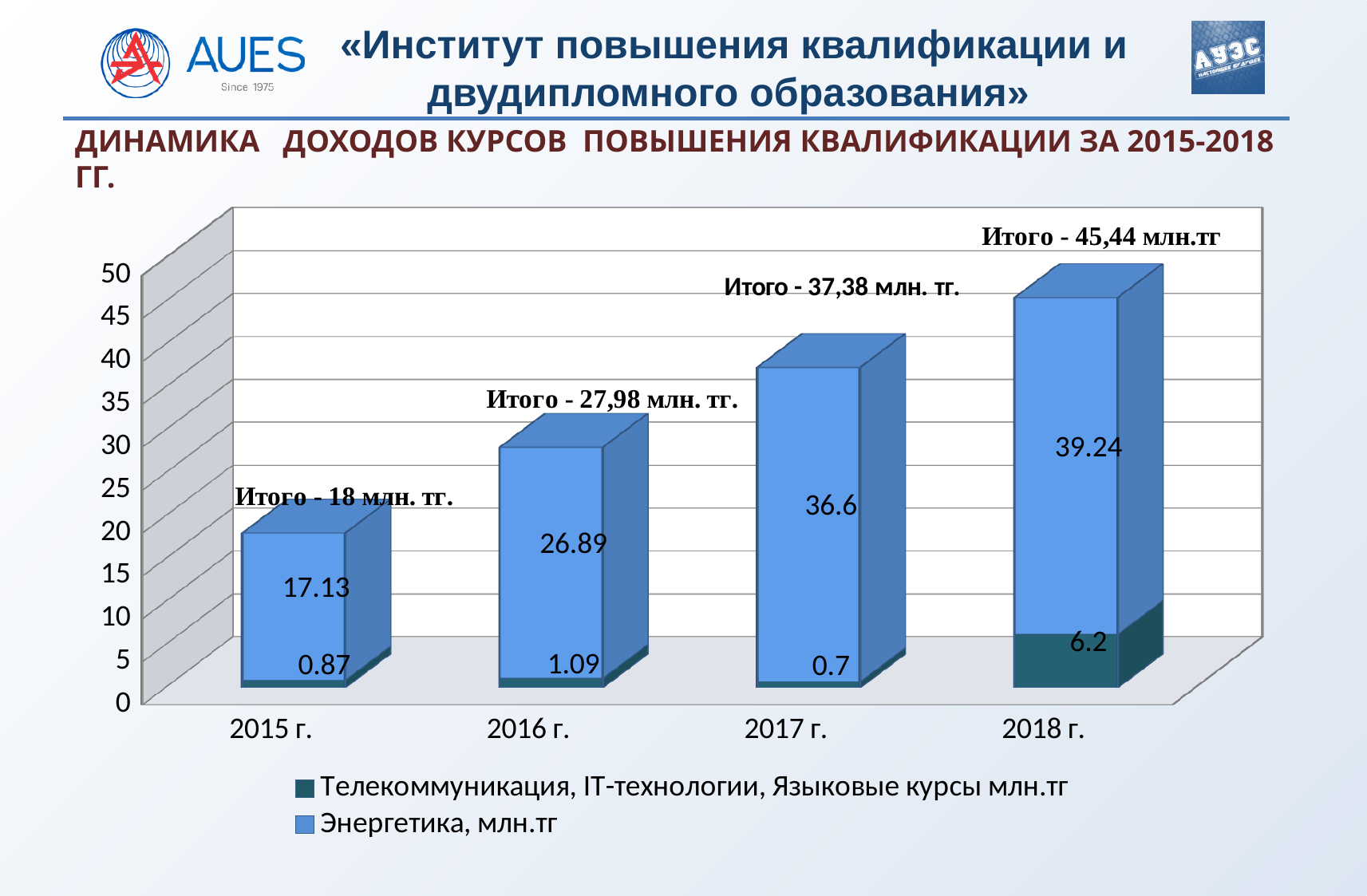
Do the total values rise or fall from 2015 г. to 2018 г.? Rise Which is larger: the Телекоммуникация, IT-технологии, Языковые курсы value in 2016 г. or in 2015 г.? 2016 г. What is the value for Энергетика in 2017 г.? 36.6 How many series does the legend list? 2 How many years are shown on the x axis? 4 What is the value for Телекоммуникация, IT-технологии, Языковые курсы in 2018 г.? 6.2 Which year has the highest value for Энергетика? 2018 г. What is the value for Энергетика in 2015 г.? 17.13 What is the total shown for 2016 г.? 27,98 млн. тг. What kind of chart is shown on the slide? Stacked bar chart What is the difference between the Энергетика values for 2018 г. and 2017 г.? 2.64 Which year has the lowest value for Телекоммуникация, IT-технологии, Языковые курсы? 2017 г.